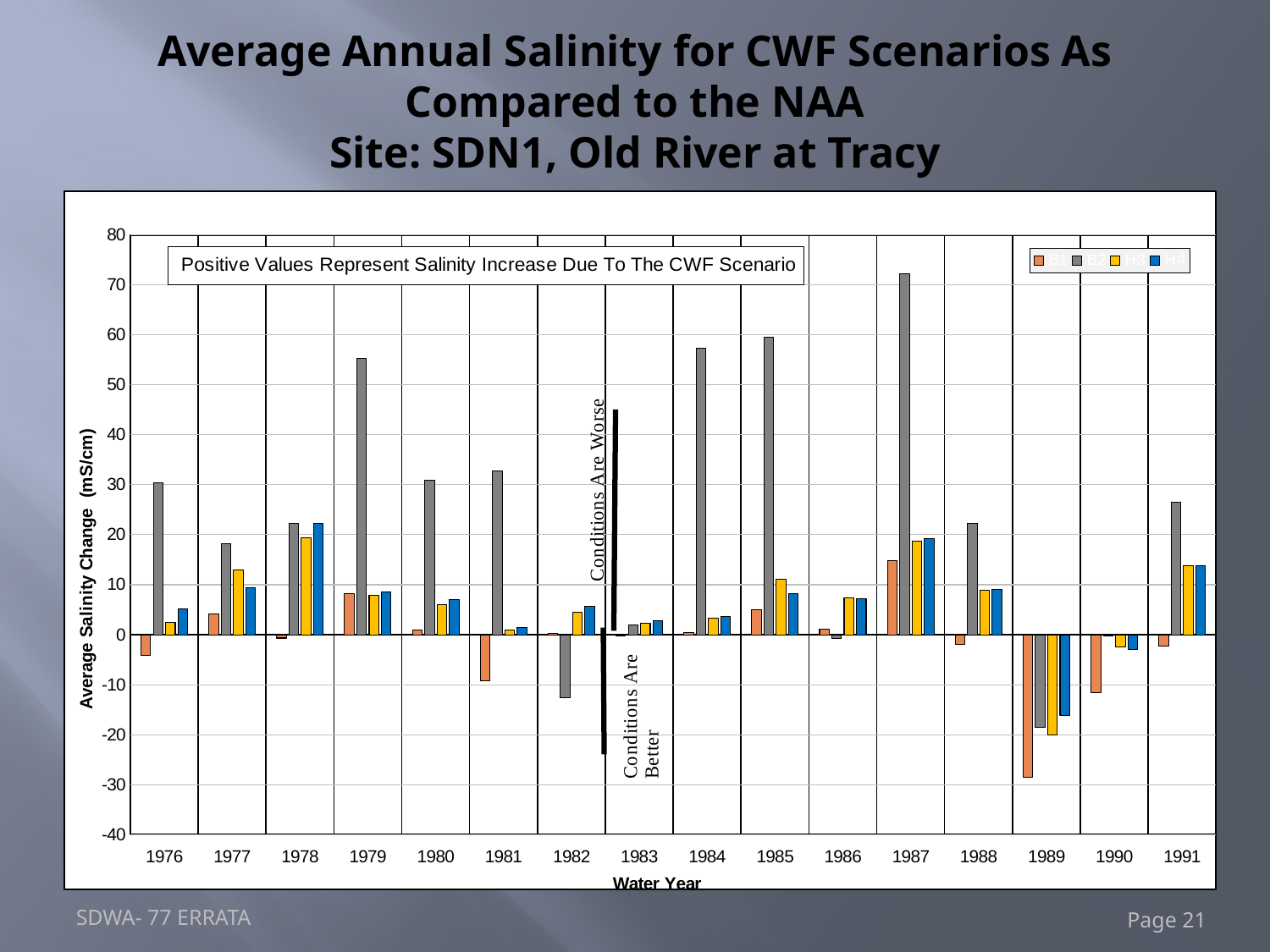
Is the value of the orange bar for 1989 greater or less than -20? less In which water year does the grey series reach its highest value? 1987 What is the label of the chart's y axis? Average Salinity Change (mS/cm) How many water years are shown along the x axis of the chart? 16 What kind of chart is shown on the slide? bar chart Is the value of the grey bar for 1982 greater or less than -10? less Is the value of the grey bar for 1979 greater or less than 50? greater In which water year does the orange series reach its lowest value? 1989 What is the label of the chart's x axis? Water Year How many series does the chart's legend list? 4 Which is larger, the grey bar for 1987 or the grey bar for 1979? 1987